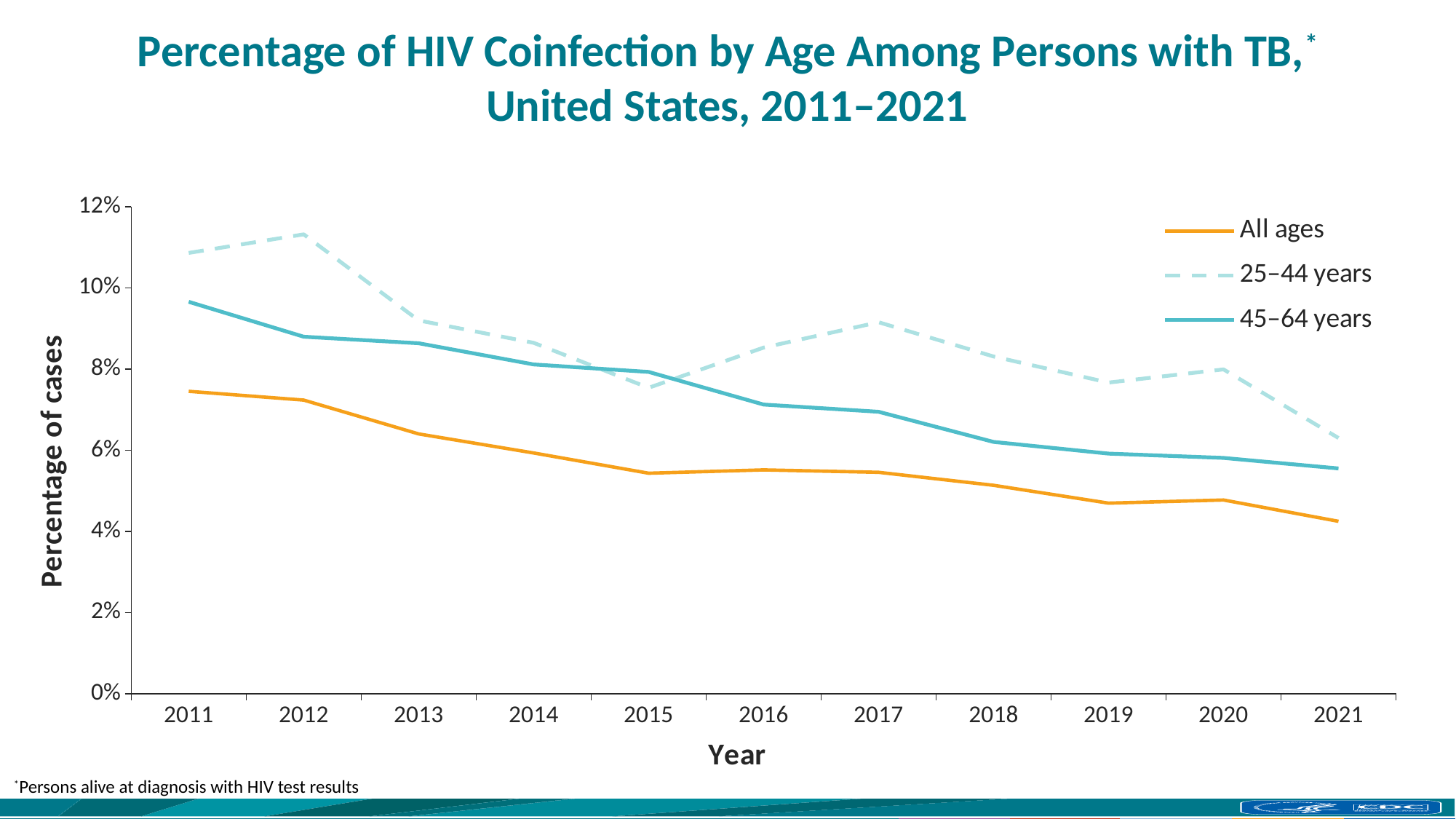
Is the value for All ages in 2011 greater or less than 8%? less How many years are plotted along the x axis? 11 Does the All ages line rise or fall from 2011 to 2021? fall In which year does the 25–44 years series reach its highest value? 2012 In which year does the All ages series reach its lowest value? 2021 Is the value for 25–44 years in 2012 greater or less than 10%? greater Is the value for 45–64 years in 2021 greater or less than 6%? less How many series does the legend list? 3 What kind of chart is shown on the slide? line chart In 2011, which series has the higher value, 25–44 years or 45–64 years? 25–44 years Which series is drawn with a dashed line? 25–44 years